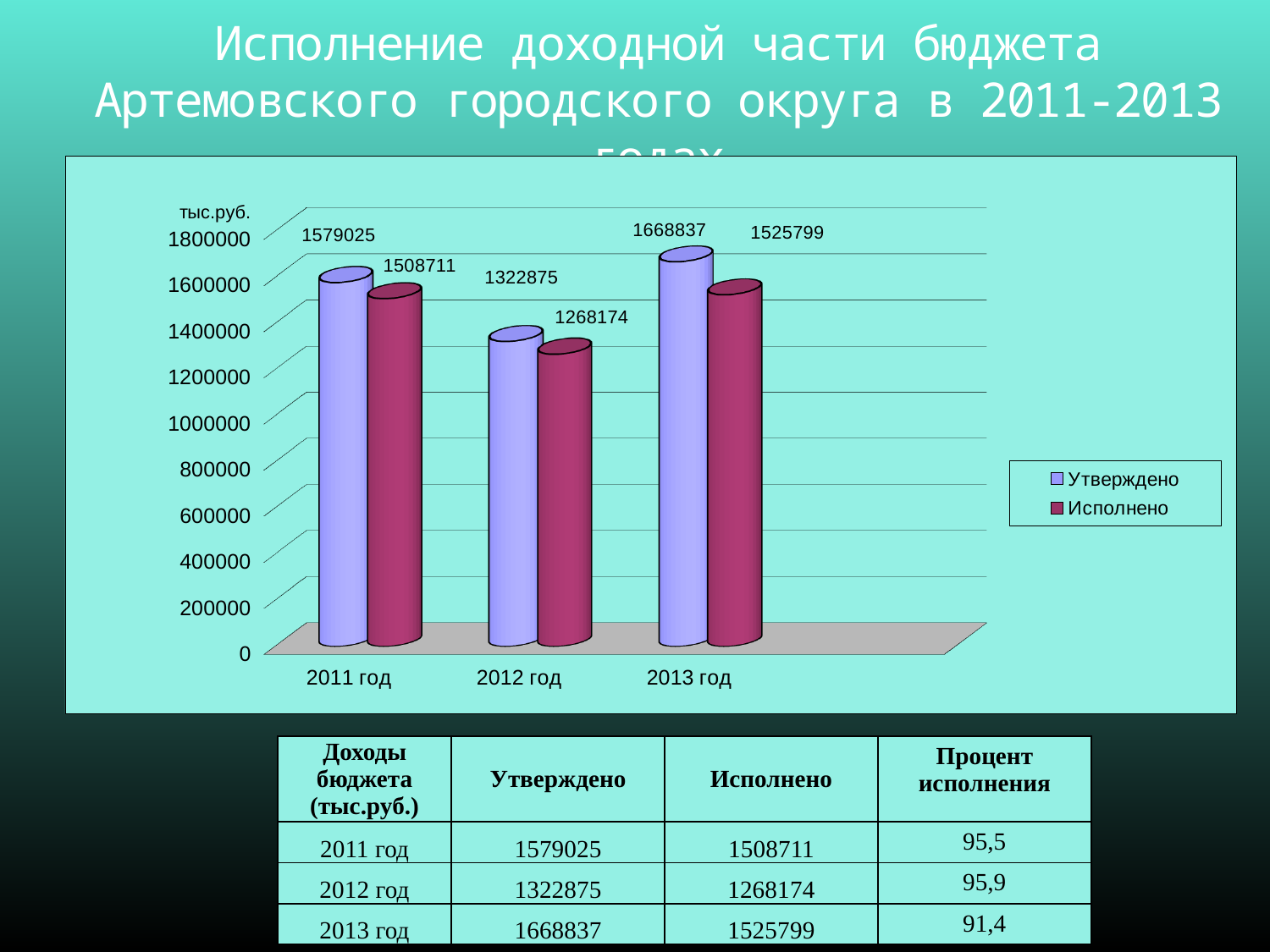
What unit is shown on the vertical axis of the chart? тыс.руб. How many series does the chart legend list? 2 How many years are shown on the x axis of the chart? 3 Which year has the highest Утверждено value? 2013 год Which is larger: Исполнено for 2011 год or Исполнено for 2013 год? Исполнено for 2013 год What is the value of Утверждено for 2011 год? 1579025 What is the value of Исполнено for 2012 год? 1268174 Which year has the lowest Исполнено value? 2012 год What is the difference between Утверждено and Исполнено for 2013 год? 143038 What is the value of Исполнено for 2013 год? 1525799 What is the difference between Утверждено and Исполнено for 2011 год? 70314 Is the Утверждено value for 2012 год greater or less than 1400000? less